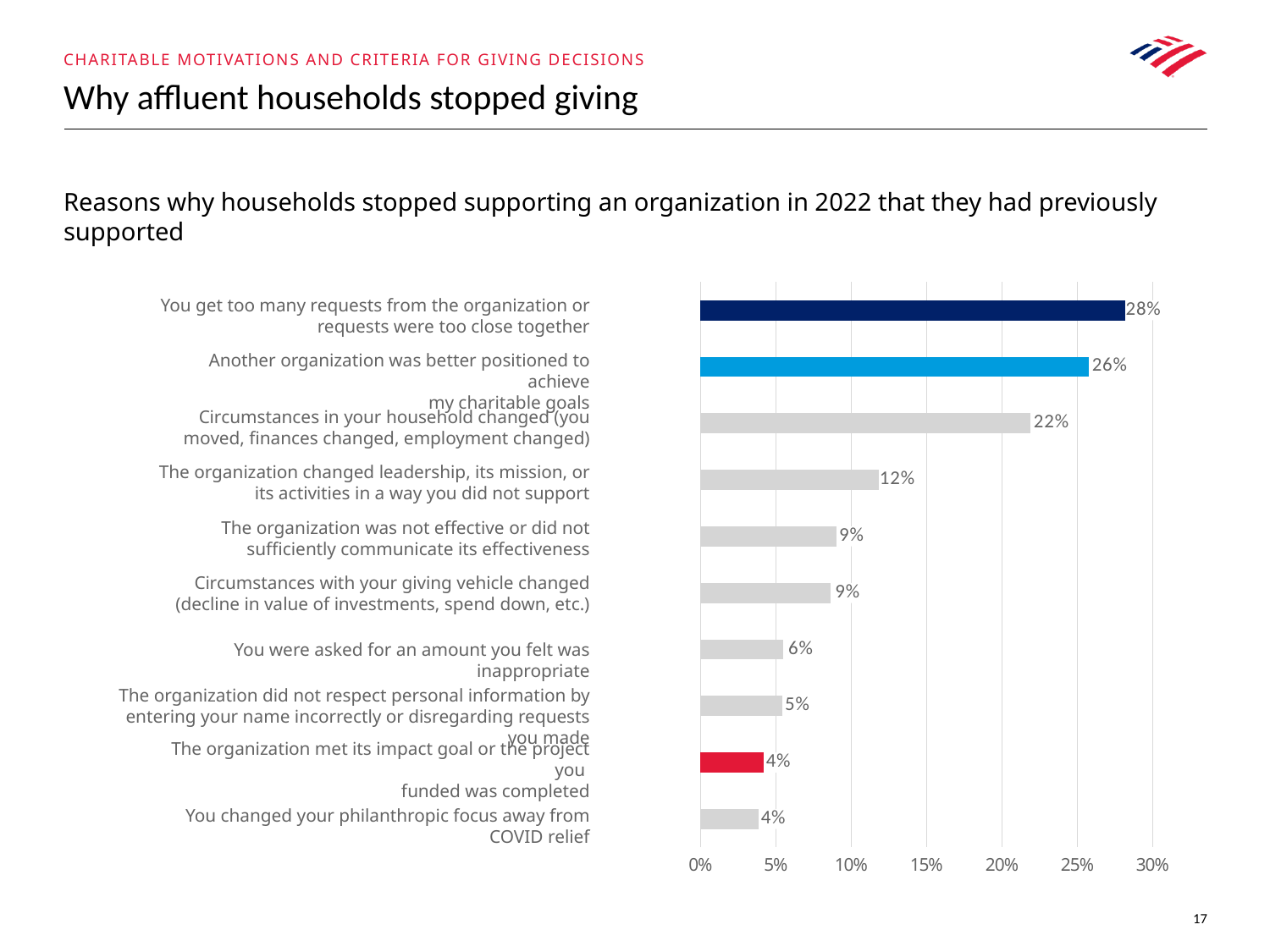
What percentage of households stopped giving because they got too many requests from the organization or requests were too close together? 28% What value is shown for 'Another organization was better positioned to achieve my charitable goals'? 26% What value is shown for 'You changed your philanthropic focus away from COVID relief'? 4% What is the difference between the percentage for 'Circumstances in your household changed' and 'The organization changed leadership, its mission, or its activities in a way you did not support'? 10% Is the value for 'Circumstances in your household changed' greater or less than 20%? greater What kind of chart is shown on the slide? bar chart Which reason has the highest percentage in the chart? You get too many requests from the organization or requests were too close together How many reasons (categories) are shown in the chart? 10 Which is larger: the value for 'You were asked for an amount you felt was inappropriate' or the value for 'The organization did not respect personal information by entering your name incorrectly or disregarding requests you made'? You were asked for an amount you felt was inappropriate What percentage is shown for 'The organization changed leadership, its mission, or its activities in a way you did not support'? 12% What is the lowest percentage value shown in the chart? 4% Which reason is shown with a red bar? The organization met its impact goal or the project you funded was completed